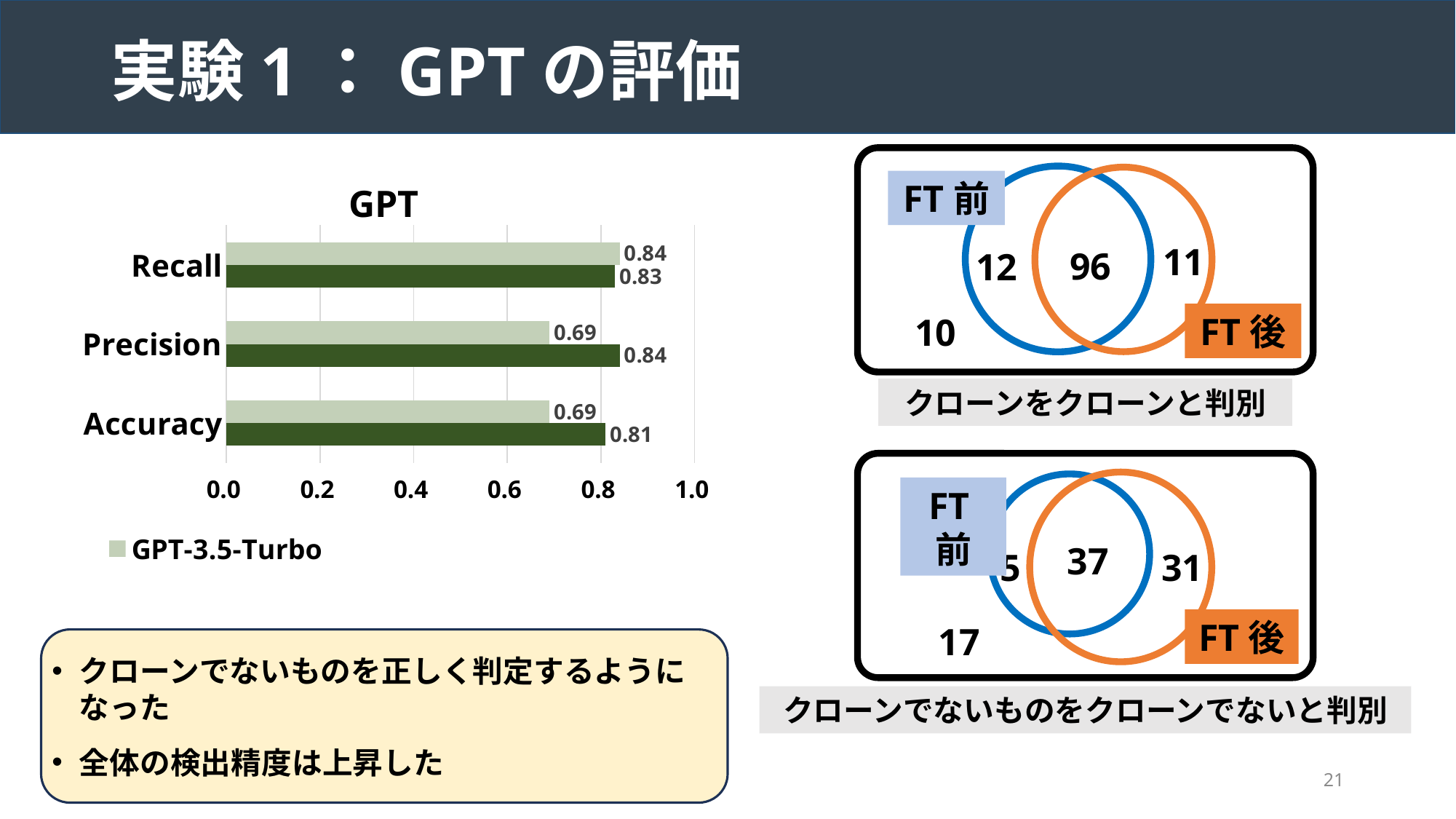
In the "GPT" chart, what is the Precision value shown on the dark green bar? 0.84 In the "GPT" chart, which category has the lowest value for the dark green series? Accuracy In the "GPT" chart, how many categories are shown on the vertical axis? 3 In the "GPT" chart, what is the Accuracy value shown on the dark green bar? 0.81 What kind of chart is the chart titled "GPT"? bar chart In the "GPT" chart, what is the difference between the dark green bar and the light green bar for Precision? 0.15 In the "GPT" chart, for Precision, which bar is larger: the light green GPT-3.5-Turbo bar or the dark green bar? the dark green bar In the "GPT" chart, what is the difference between the dark green bar and the light green bar for Accuracy? 0.12 In the "GPT" chart, what is the Precision value for GPT-3.5-Turbo (the light green bar)? 0.69 In the "GPT" chart, is the GPT-3.5-Turbo Accuracy value greater or less than 0.8? less What series name is listed in the legend of the "GPT" chart? GPT-3.5-Turbo In the "GPT" chart, what is the Recall value for GPT-3.5-Turbo (the light green bar)? 0.84